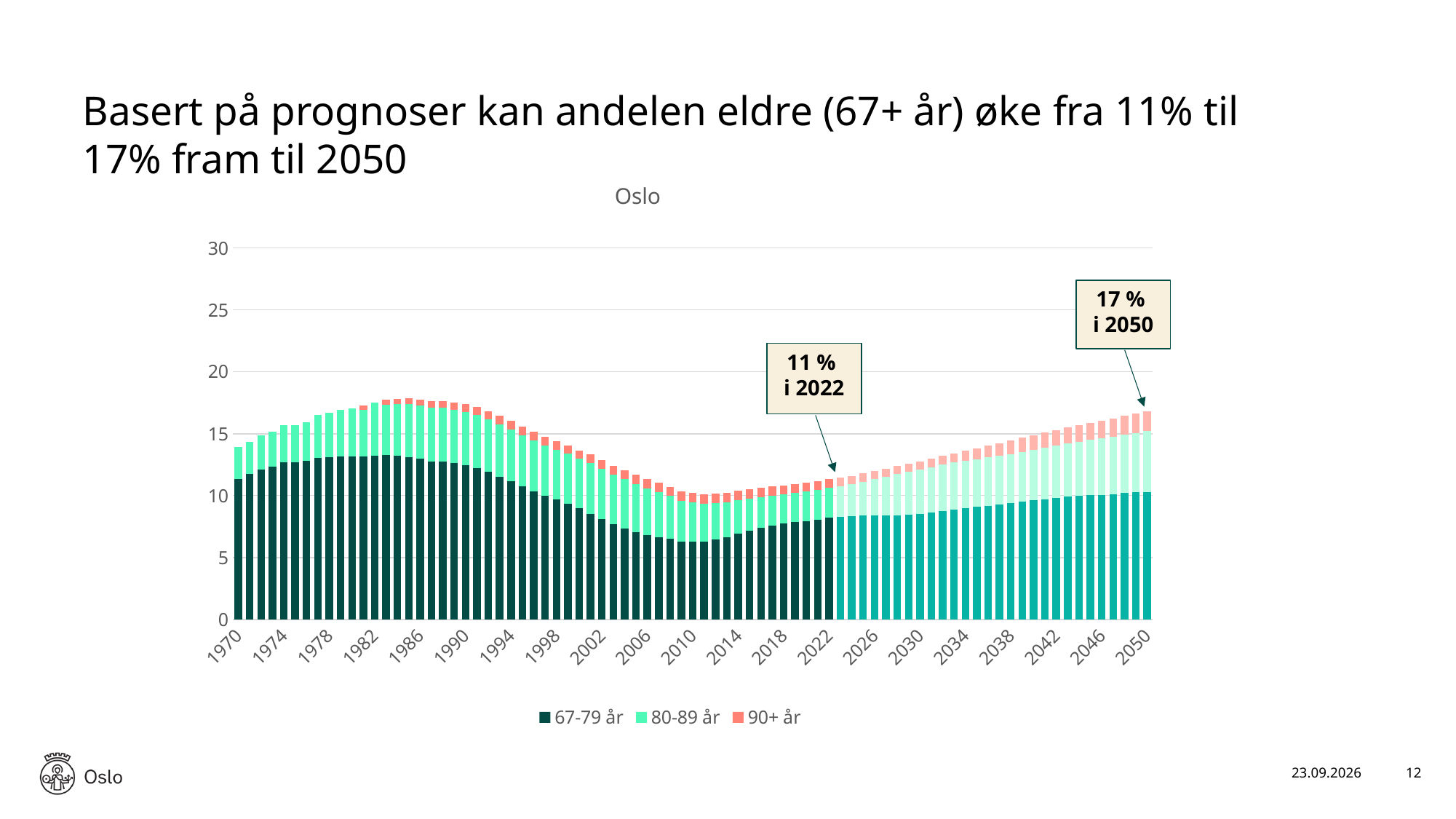
Is the value for 67-79 år in 1970 greater or less than 10? greater Do the total stacked values rise or fall from 2022 to 2050? rise Which year has a larger total stacked value, 1986 or 2010? 1986 By how many percentage points does the share of elderly increase from 2022 to 2050, according to the callouts? 6 percentage points Is the total stacked value for 2010 greater or less than 15? less What kind of chart is shown on the slide? Stacked bar chart According to the callout, what is the share of elderly (67+ år) in 2022? 11 % According to the callout, what is the share of elderly (67+ år) in 2050? 17 % What is the title of the chart? Oslo What are the three series listed in the legend? 67-79 år, 80-89 år, 90+ år How many series does the legend list? 3 Is the total stacked value for 1986 greater or less than 15? greater